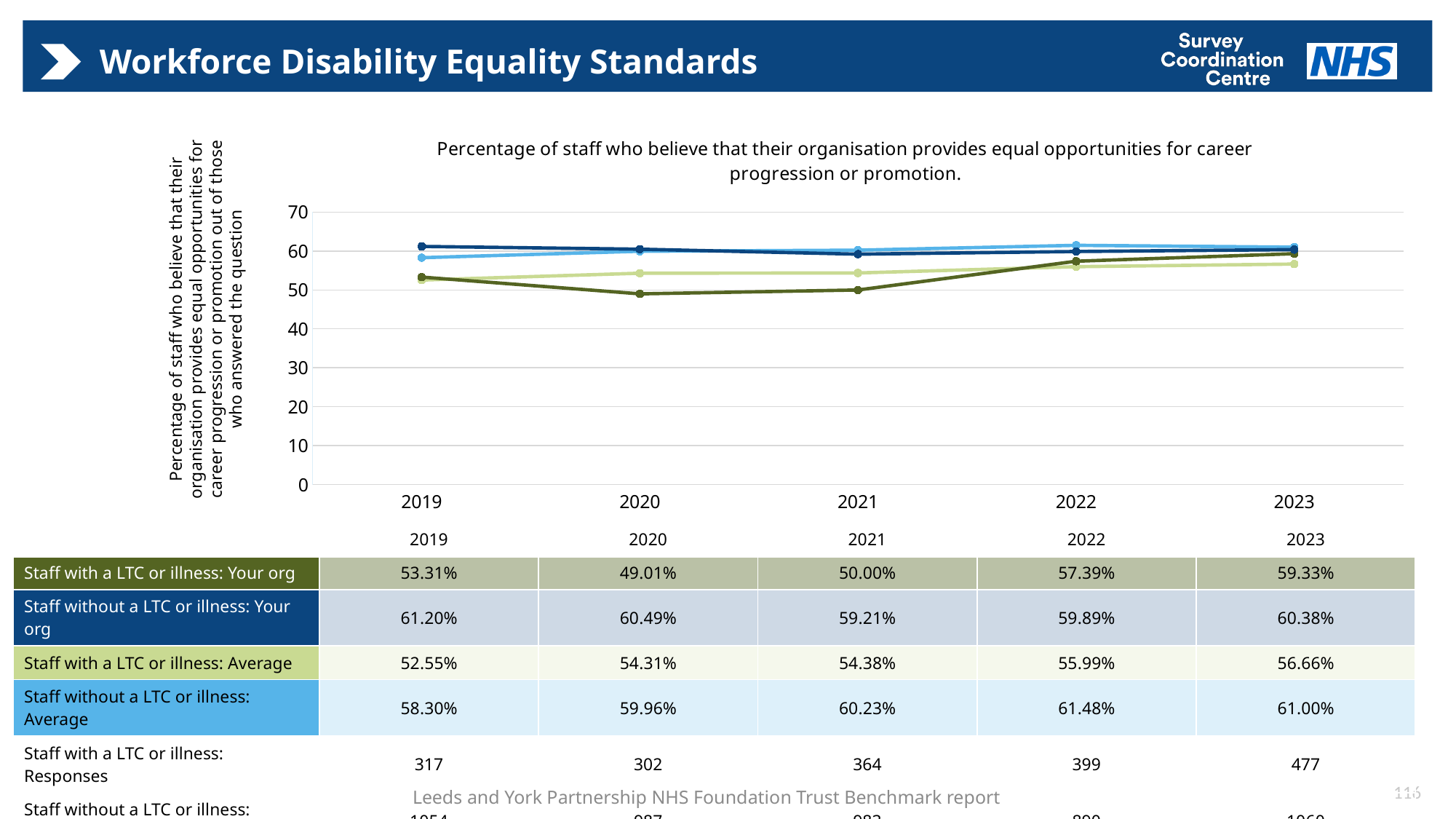
What is the value for Staff with a LTC or illness: Your org in 2020? 49.01% Does the value for Staff with a LTC or illness: Your org rise or fall from 2021 to 2023? rise Is the value for Staff with a LTC or illness: Your org in 2020 greater or less than 50? less What kind of chart is shown on the slide? line chart In which year is the value for Staff without a LTC or illness: Your org highest? 2019 How many years are shown on the x axis of the chart? 5 In which year is the value for Staff with a LTC or illness: Your org lowest? 2020 In 2021, which is larger: Staff with a LTC or illness: Average or Staff with a LTC or illness: Your org? Staff with a LTC or illness: Average What is the value for Staff without a LTC or illness: Average in 2022? 61.48% What is the title of the chart? Percentage of staff who believe that their organisation provides equal opportunities for career progression or promotion. How many series are plotted on the chart? 4 What is the difference between Staff without a LTC or illness: Your org and Staff with a LTC or illness: Your org in 2023? 1.05 percentage points